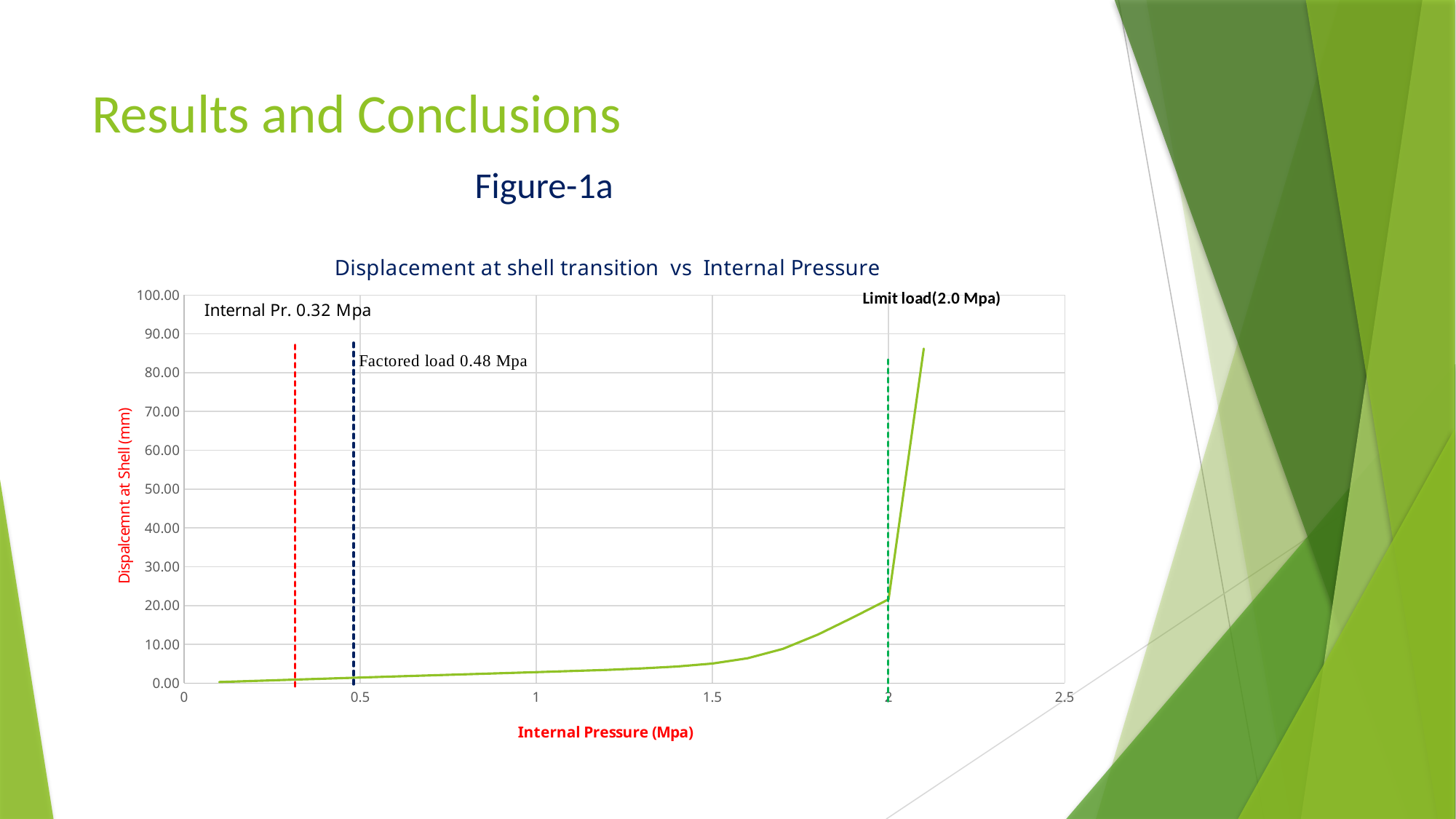
Is the displacement at an internal pressure of 2 Mpa greater or less than 30? less Is the displacement at an internal pressure of 1.5 Mpa greater or less than 10? less What is the highest value shown on the x axis of the chart? 2.5 What is the label of the x axis of the chart? Internal Pressure (Mpa) What is the title of the chart? Displacement at shell transition vs Internal Pressure Is the displacement at an internal pressure of 1 Mpa greater or less than 10? less Does the displacement rise or fall as internal pressure increases along the x axis? rise What is the highest value shown on the y axis of the chart? 100.00 Which is larger, the displacement at 1.5 Mpa or the displacement at 2 Mpa? 2 Mpa What kind of chart is shown on the slide? line chart